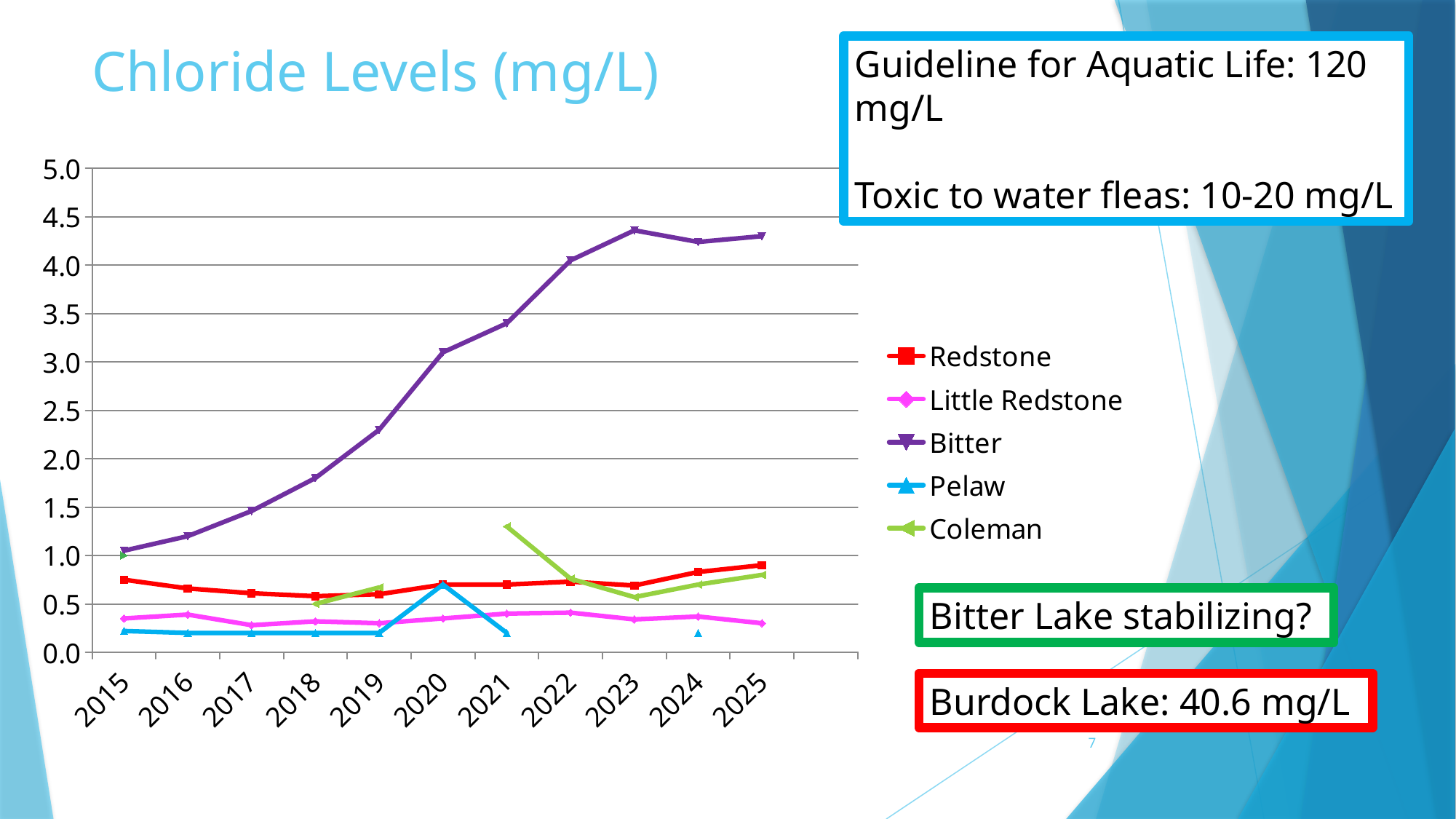
How many years are shown along the x axis? 11 Is the value for Coleman in 2021 greater or less than 1.0? greater Which lake has the lowest chloride level in 2025? Little Redstone Which lake has the highest chloride level in 2025? Bitter Is the value for Little Redstone in 2025 greater or less than 0.5? less What kind of chart is shown on the slide? line chart What is the title of the chart? Chloride Levels (mg/L) Is the value for Bitter in 2023 greater or less than 4.0? greater How many series does the legend list? 5 Which is larger in 2025, the value for Redstone or the value for Little Redstone? Redstone Does the Bitter line rise or fall from 2015 to 2023? rises